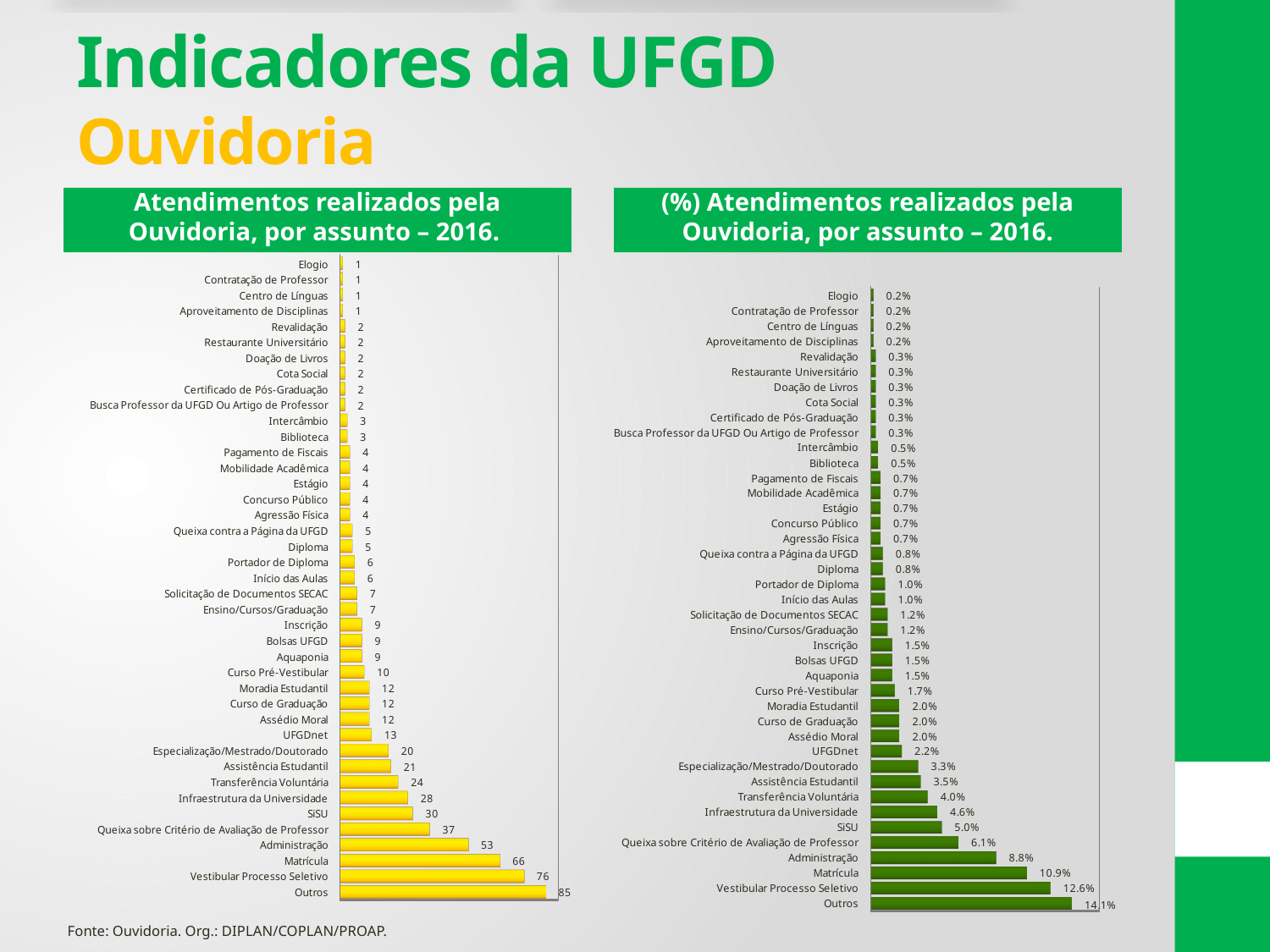
In the right chart '(%) Atendimentos realizados pela Ouvidoria, por assunto – 2016', what is the value for Administração? 8.8% In the left chart 'Atendimentos realizados pela Ouvidoria, por assunto – 2016', what is the difference between Vestibular Processo Seletivo and Matrícula? 10 In the left chart 'Atendimentos realizados pela Ouvidoria, por assunto – 2016', which category has the highest value? Outros What kind of chart is the right chart '(%) Atendimentos realizados pela Ouvidoria, por assunto – 2016'? Bar chart How many categories are shown in the left chart 'Atendimentos realizados pela Ouvidoria, por assunto – 2016'? 41 In the right chart '(%) Atendimentos realizados pela Ouvidoria, por assunto – 2016', what is the value for Vestibular Processo Seletivo? 12.6% In the left chart 'Atendimentos realizados pela Ouvidoria, por assunto – 2016', what is the value for Administração? 53 In the right chart '(%) Atendimentos realizados pela Ouvidoria, por assunto – 2016', what is the difference between Matrícula and Administração? 2.1% In the left chart 'Atendimentos realizados pela Ouvidoria, por assunto – 2016', what is the value for Queixa sobre Critério de Avaliação de Professor? 37 In the left chart 'Atendimentos realizados pela Ouvidoria, por assunto – 2016', what is the value for Matrícula? 66 In the right chart '(%) Atendimentos realizados pela Ouvidoria, por assunto – 2016', which is larger: Assistência Estudantil or Transferência Voluntária? Transferência Voluntária In the left chart 'Atendimentos realizados pela Ouvidoria, por assunto – 2016', which is larger: SiSU or Infraestrutura da Universidade? SiSU